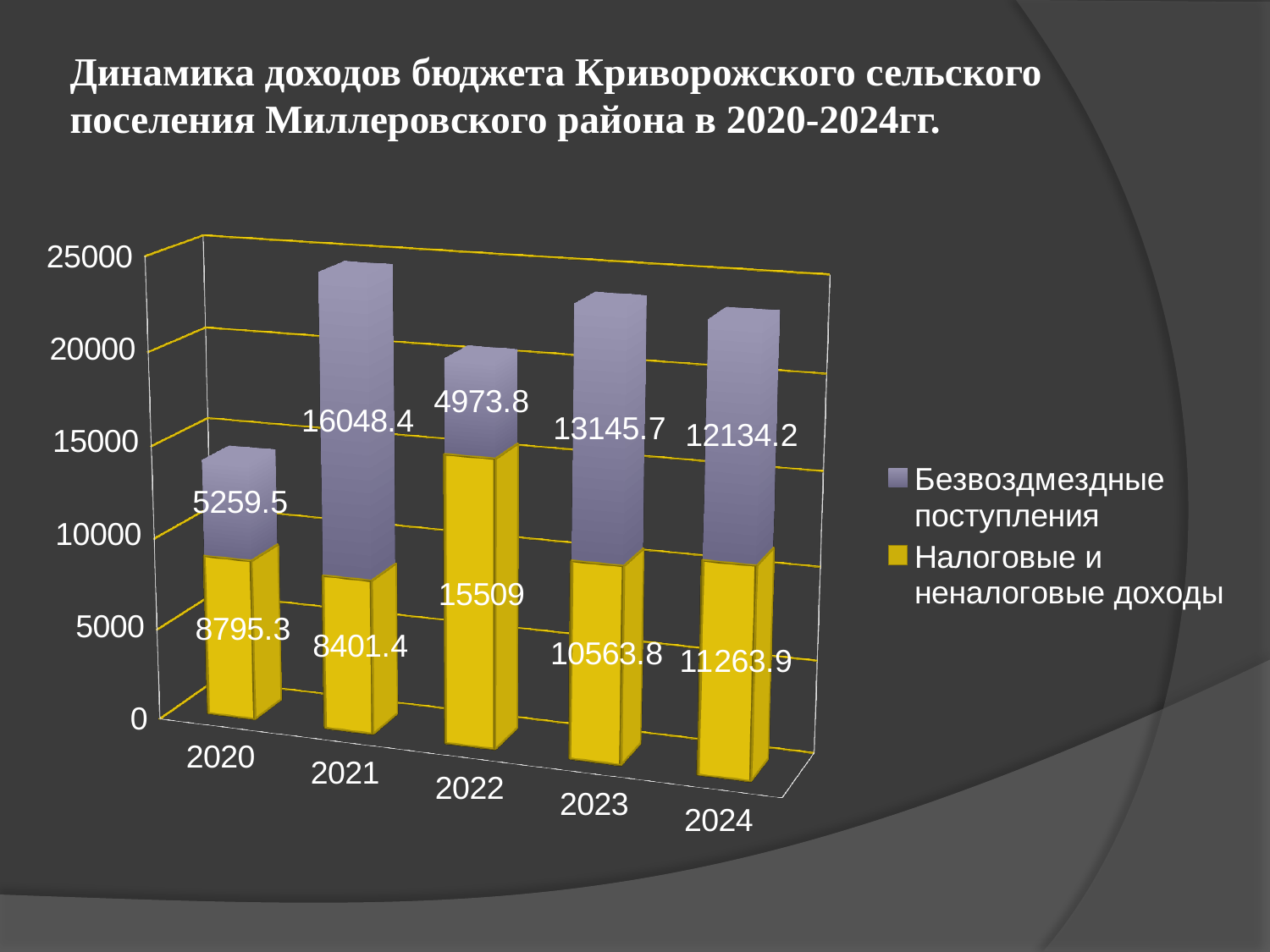
What is the total of the stacked bar for 2020? 14054.8 In which year is Налоговые и неналоговые доходы the lowest? 2021 What type of chart is shown on the slide? Stacked bar chart What is the value of Налоговые и неналоговые доходы for 2022? 15509 What is the value of Налоговые и неналоговые доходы for 2024? 11263.9 In which year is Безвоздмездные поступления the lowest? 2022 What is the value of Безвоздмездные поступления for 2021? 16048.4 In which year is Безвоздмездные поступления the highest? 2021 What is the difference between Налоговые и неналоговые доходы in 2024 and in 2023? 700.1 Which is larger in 2020: Налоговые и неналоговые доходы or Безвоздмездные поступления? Налоговые и неналоговые доходы How many series does the legend list? 2 How many years are shown on the x axis? 5